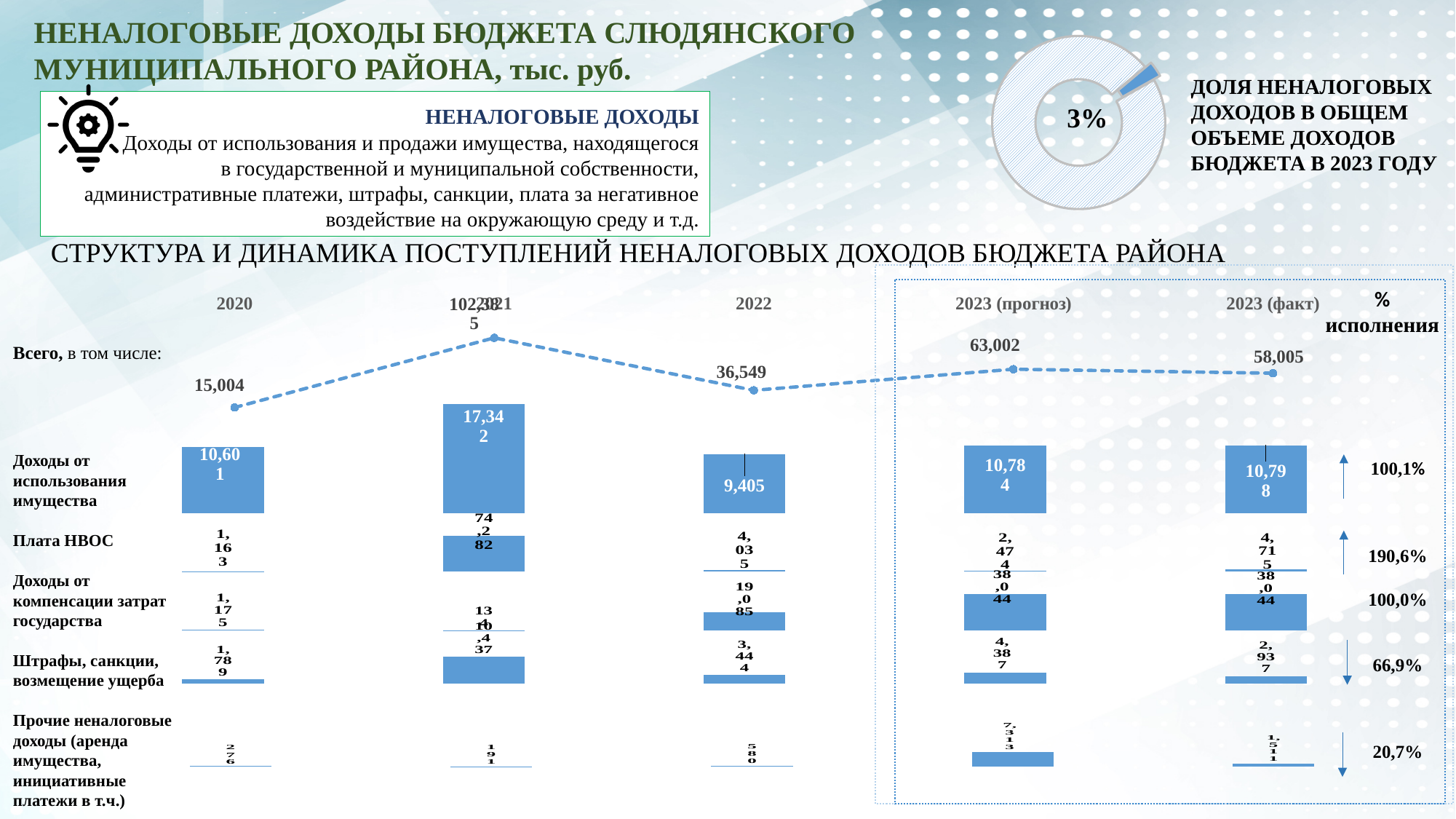
In the chart 'Структура и динамика поступлений неналоговых доходов бюджета района', what is the total ('Всего') value for 2023 (факт)? 58,005 In the chart 'Структура и динамика поступлений неналоговых доходов бюджета района', what is the total ('Всего') value for 2020? 15,004 In the donut chart at the top right, what share of total budget revenue in 2023 do non-tax revenues make up? 3% In the chart 'Структура и динамика поступлений неналоговых доходов бюджета района', which revenue category has the lowest '% исполнения'? Прочие неналоговые доходы In the chart 'Структура и динамика поступлений неналоговых доходов бюджета района', which year has the highest total ('Всего') value? 2021 In the chart 'Структура и динамика поступлений неналоговых доходов бюджета района', what is the value of 'Плата НВОС' for 2023 (факт)? 4,715 In the chart 'Структура и динамика поступлений неналоговых доходов бюджета района', which year has the larger value for 'Доходы от использования имущества': 2020 or 2021? 2021 In the chart 'Структура и динамика поступлений неналоговых доходов бюджета района', what is the '% исполнения' shown for 'Плата НВОС'? 190,6% In the chart 'Структура и динамика поступлений неналоговых доходов бюджета района', what is the difference between the total for 2023 (прогноз) and the total for 2023 (факт)? 4,997 In the chart 'Структура и динамика поступлений неналоговых доходов бюджета района', what is the value of 'Доходы от использования имущества' for 2022? 9,405 What kind of chart is shown at the top right of the slide next to the text 'Доля неналоговых доходов в общем объеме доходов бюджета в 2023 году'? Pie (donut) chart In the chart 'Структура и динамика поступлений неналоговых доходов бюджета района', what is the value of 'Прочие неналоговые доходы' for 2023 (прогноз)? 7,313